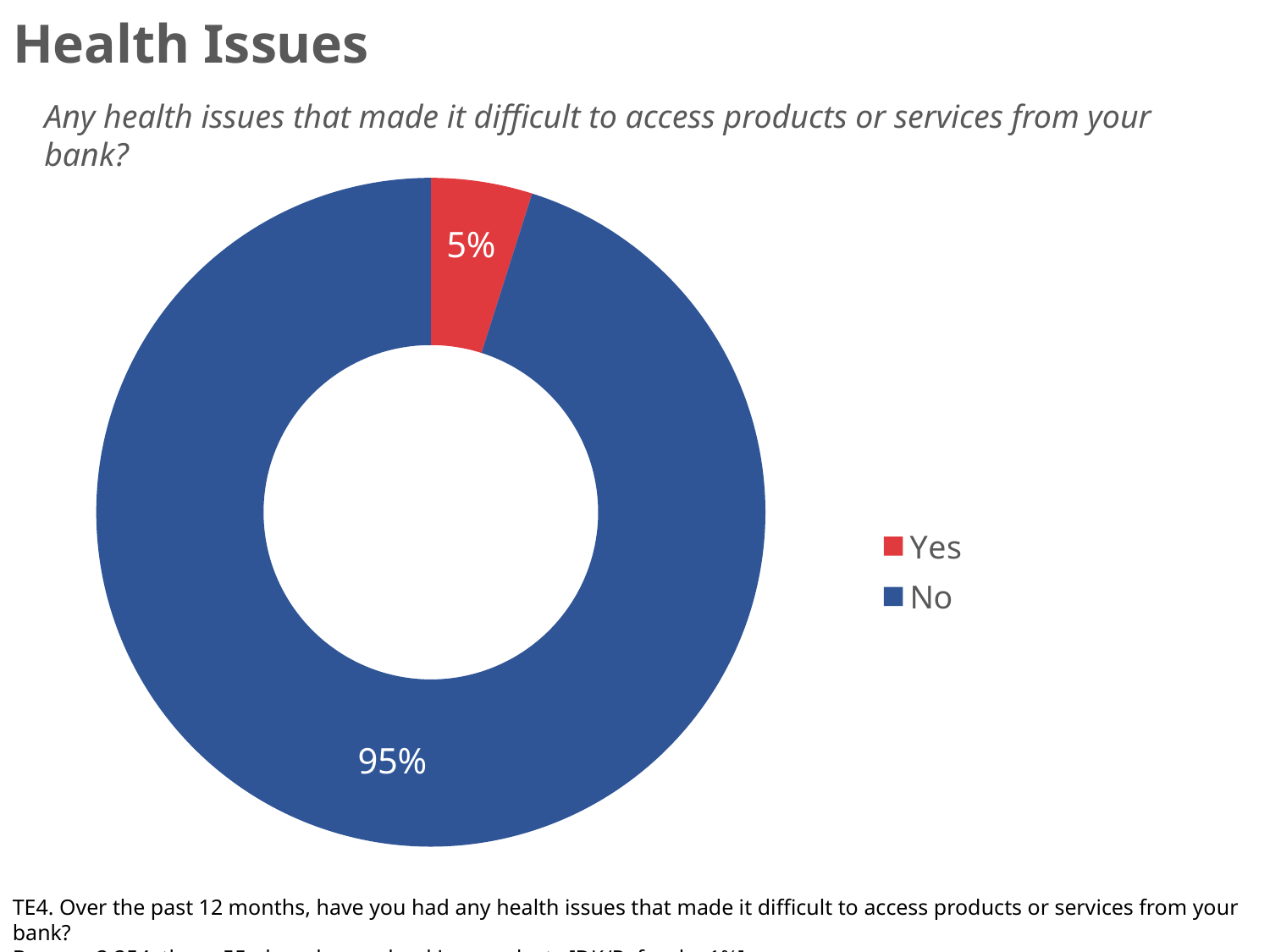
What is the title of the slide? Health Issues What kind of chart is shown on the slide? Doughnut chart What share of the chart does the "Yes" slice represent? 5% What percentage of respondents answered "No"? 95% Which response has the smallest share of the chart? Yes Which is larger, the share for "Yes" or the share for "No"? No What colour is the "Yes" slice in the chart? Red What is the difference in percentage points between the "No" and "Yes" responses? 90 What percentage of respondents answered "Yes" to having health issues that made it difficult to access products or services from their bank? 5% How many categories are shown in the chart? 2 How many entries does the legend list? 2 Which response has the largest share of the chart? No